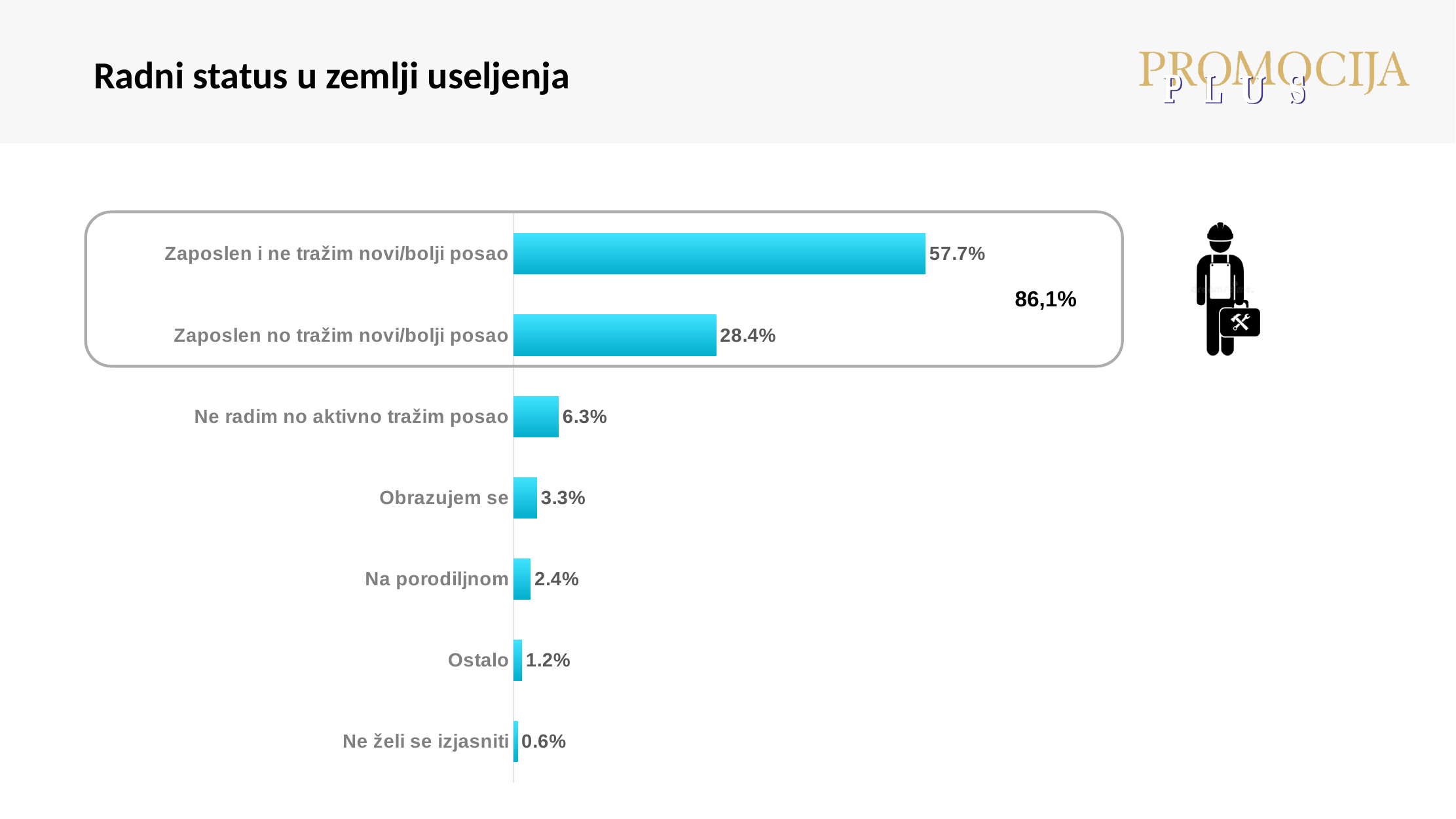
What is the value for "Zaposlen i ne tražim novi/bolji posao"? 57.7% What kind of chart is shown on the slide? Bar chart What is the value for "Zaposlen no tražim novi/bolji posao"? 28.4% What is the difference between "Zaposlen i ne tražim novi/bolji posao" and "Zaposlen no tražim novi/bolji posao"? 29.3% What combined percentage is printed inside the box grouping the two "Zaposlen" categories? 86,1% Which category has the highest value? Zaposlen i ne tražim novi/bolji posao Which category has the lowest value? Ne želi se izjasniti Which is larger, "Obrazujem se" or "Ostalo"? Obrazujem se What is the value for "Ne radim no aktivno tražim posao"? 6.3% What is the value for "Na porodiljnom"? 2.4% What is the value for "Ne želi se izjasniti"? 0.6% How many categories are shown in the chart? 7